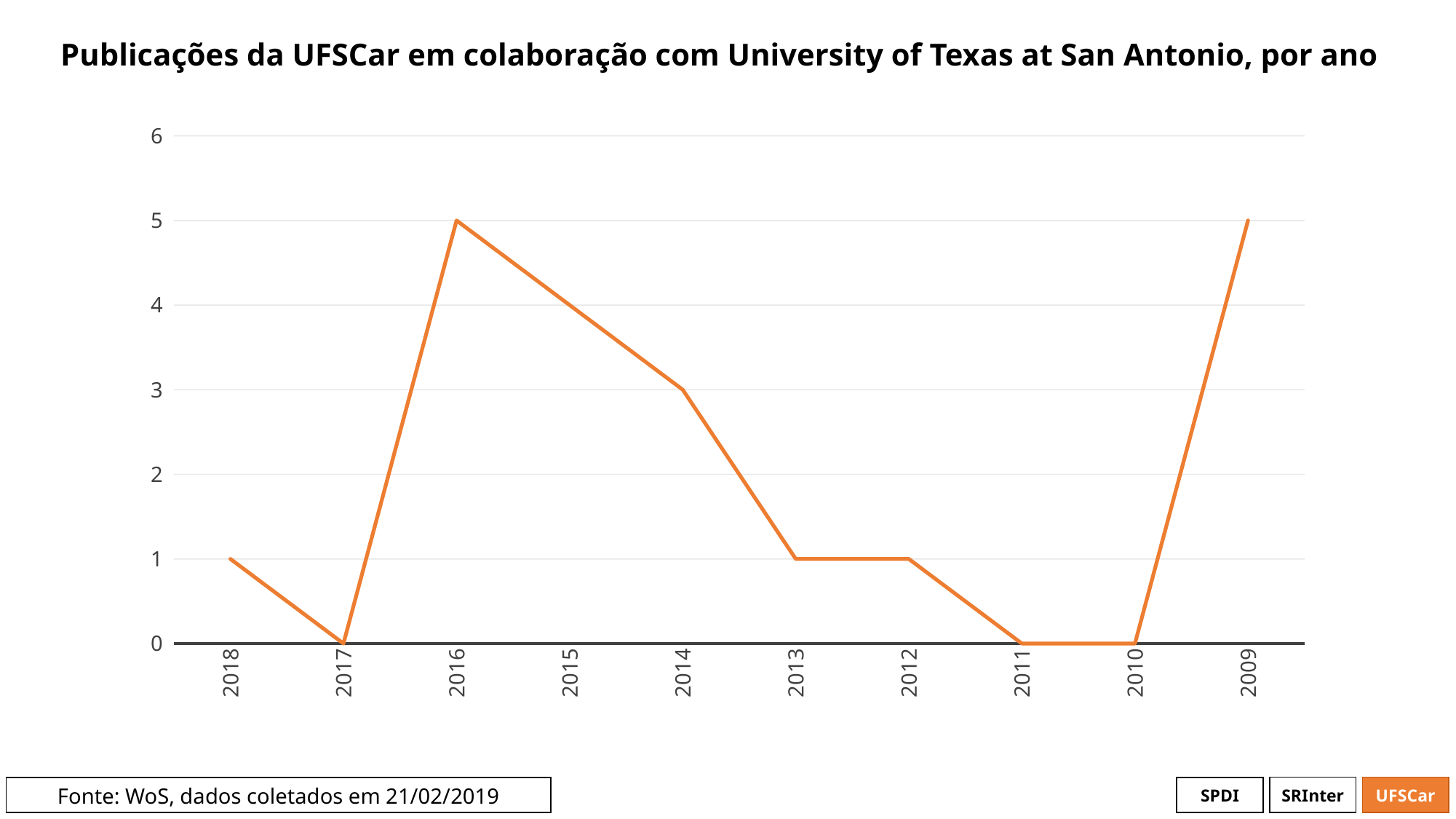
What type of chart is shown on the slide? line chart What is the value for 2009? 5 What is the value for 2014? 3 How many years are shown on the x axis? 10 What is the difference between the values for 2016 and 2014? 2 Is the value for 2016 greater or less than 4? greater Do the values rise or fall from 2016 to 2013 along the x axis? fall What is the source of the data cited on the slide? WoS, dados coletados em 21/02/2019 What is the value for 2018? 1 What is the value for 2011? 0 Which is larger, the value for 2014 or the value for 2013? 2014 What is the value for 2016? 5